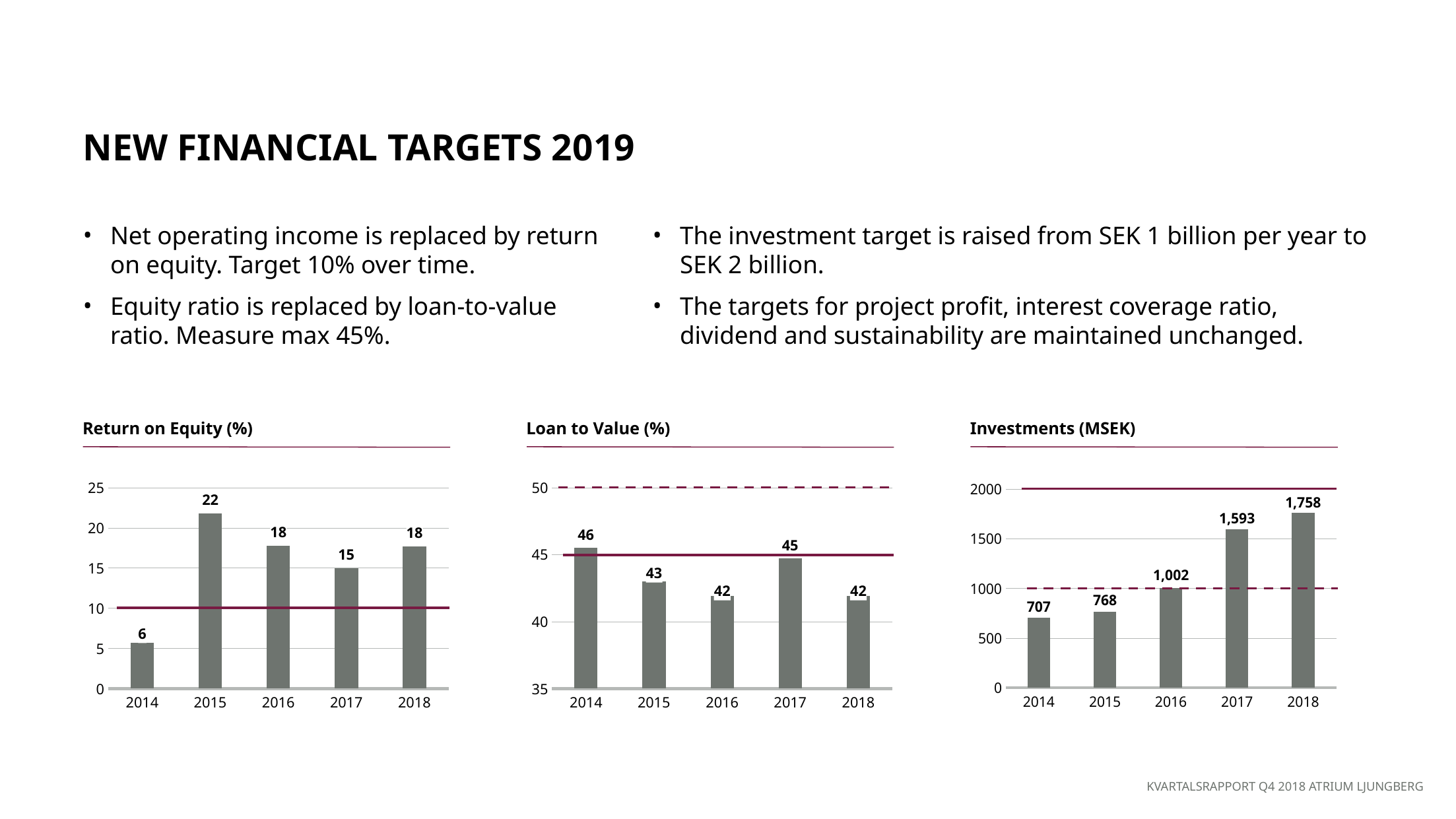
In the Return on Equity (%) chart, what is the difference between the 2015 and 2017 values? 7 In the Return on Equity (%) chart, what is the value for 2015? 22 In the Loan to Value (%) chart, is the value for 2015 larger or smaller than the value for 2016? larger In the Loan to Value (%) chart, what is the value for 2017? 45 How many years are shown on the x axis of the Investments (MSEK) chart? 5 In the Investments (MSEK) chart, what is the difference between the 2018 and 2017 values? 165 In the Investments (MSEK) chart, what is the value for 2018? 1,758 In the Investments (MSEK) chart, do the values rise or fall from 2014 to 2018? rise In the Return on Equity (%) chart, which year has the lowest value? 2014 In the Investments (MSEK) chart, what is the value for 2014? 707 In the Loan to Value (%) chart, which year has the highest value? 2014 What kind of chart is the Return on Equity (%) chart? bar chart